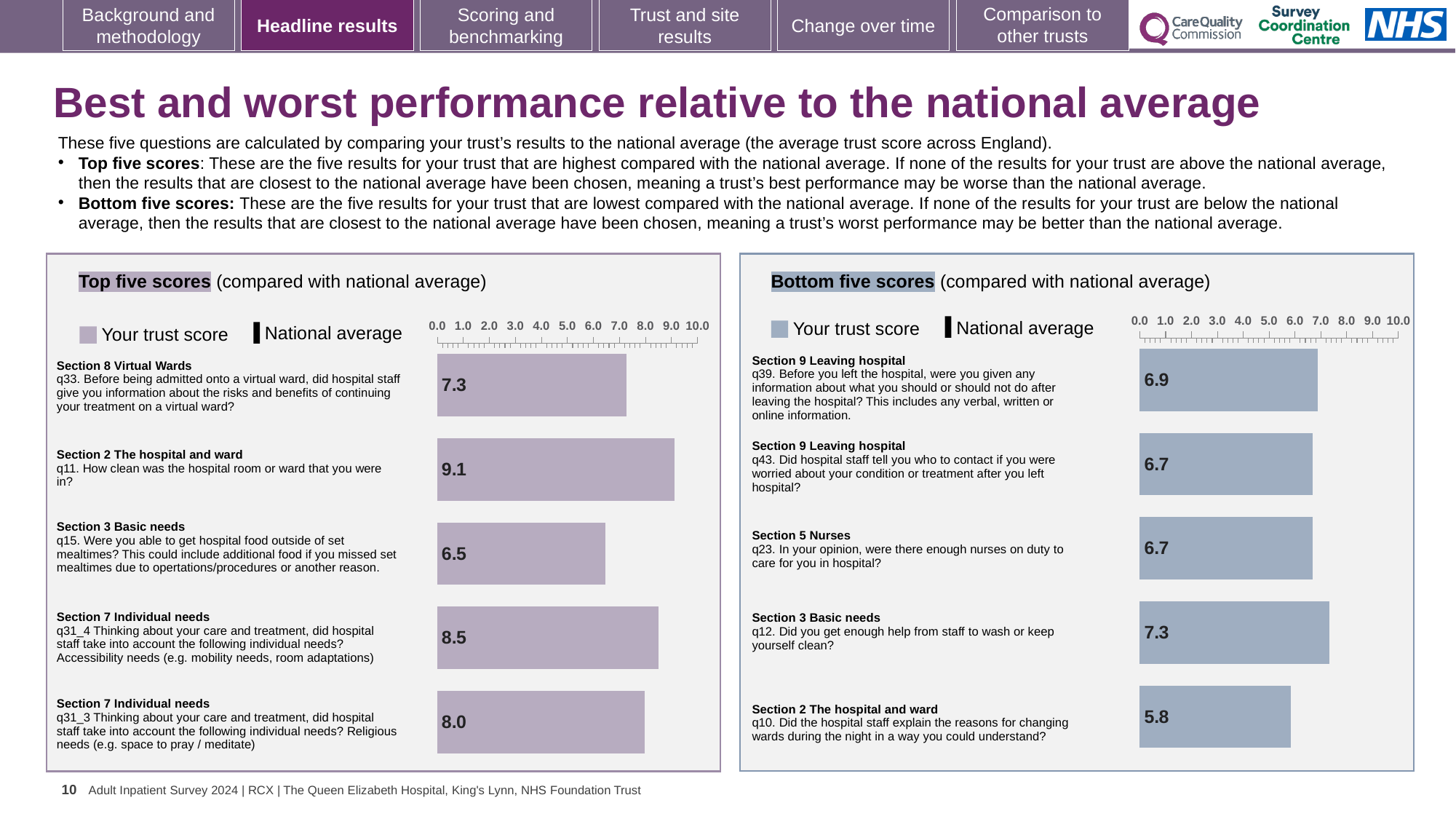
In the Top five scores chart, what is the trust score for q11 (How clean was the hospital room or ward that you were in)? 9.1 In the Bottom five scores chart, which question has the lowest trust score? q10. Did the hospital staff explain the reasons for changing wards during the night in a way you could understand? In the Top five scores chart, which question has the lowest trust score? q15. Were you able to get hospital food outside of set mealtimes? In the Bottom five scores chart, what is the trust score for q10 (Did the hospital staff explain the reasons for changing wards during the night)? 5.8 In the Top five scores chart, what is the difference between the trust scores for q11 and q15? 2.6 In the Bottom five scores chart, which has the larger trust score: q39 or q12? q12 What type of chart is used for the Bottom five scores? Bar chart How many bars are plotted in the Top five scores chart? 5 In the Bottom five scores chart, what is the difference between the trust scores for q12 and q10? 1.5 In the Top five scores chart, what is the trust score for q31_3 (Religious needs)? 8.0 In the Bottom five scores chart, which question has the highest trust score? q12. Did you get enough help from staff to wash or keep yourself clean? In the Top five scores chart, which question has the highest trust score? q11. How clean was the hospital room or ward that you were in?